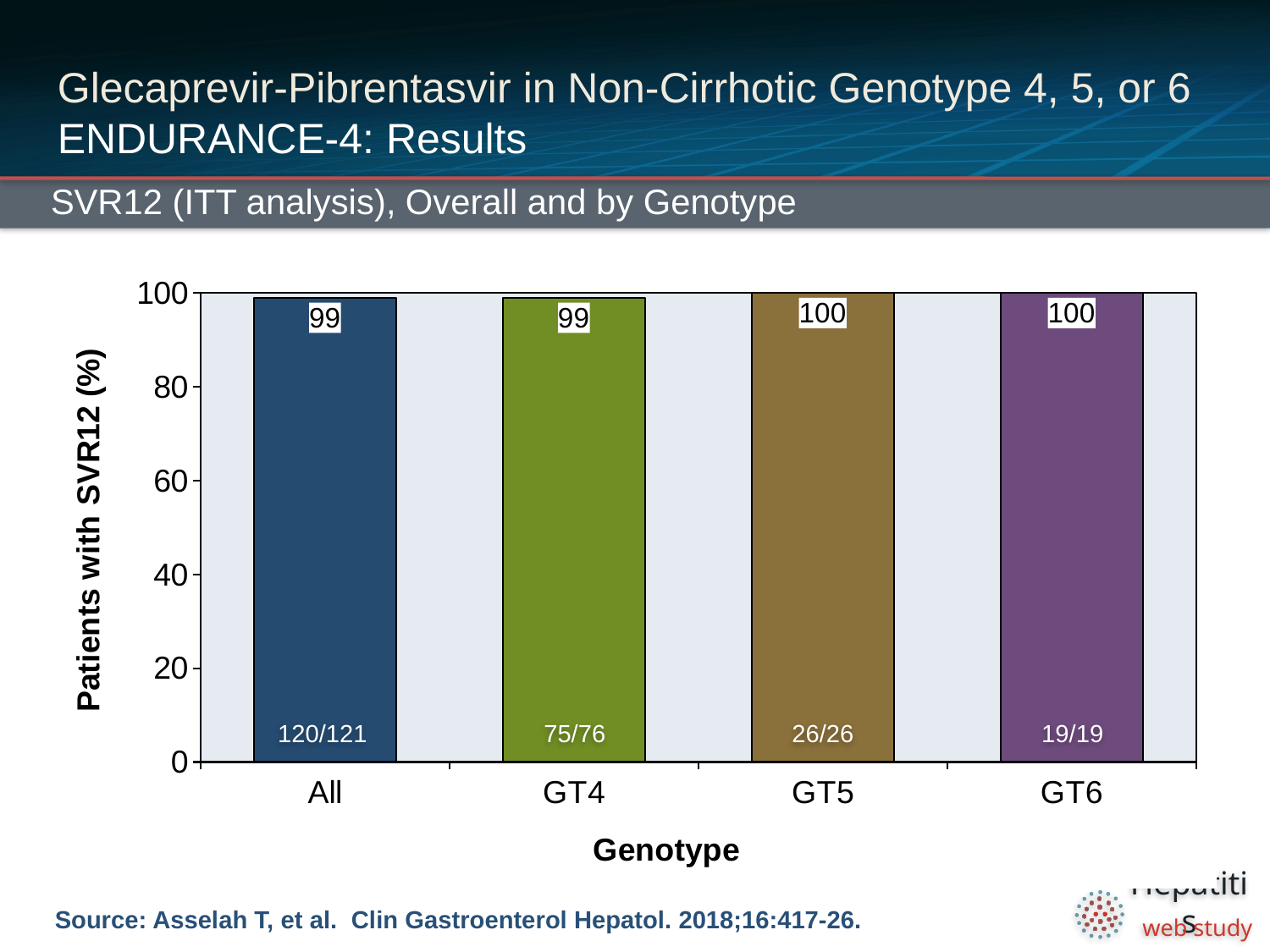
Which is larger, the SVR12 rate for GT6 or the SVR12 rate for All? GT6 What is the SVR12 rate for the All group? 99 What is the SVR12 rate for GT5? 100 What is the SVR12 rate for GT6? 100 What fraction of patients is shown at the bottom of the GT4 bar? 75/76 What kind of chart is shown on the slide? bar chart What is the SVR12 rate for GT4? 99 What is the label of the y axis? Patients with SVR12 (%) How many genotype categories are shown on the x axis? 4 What is the difference between the SVR12 rate for GT5 and the SVR12 rate for GT4? 1 What is the label of the x axis? Genotype What fraction of patients is shown at the bottom of the All bar? 120/121